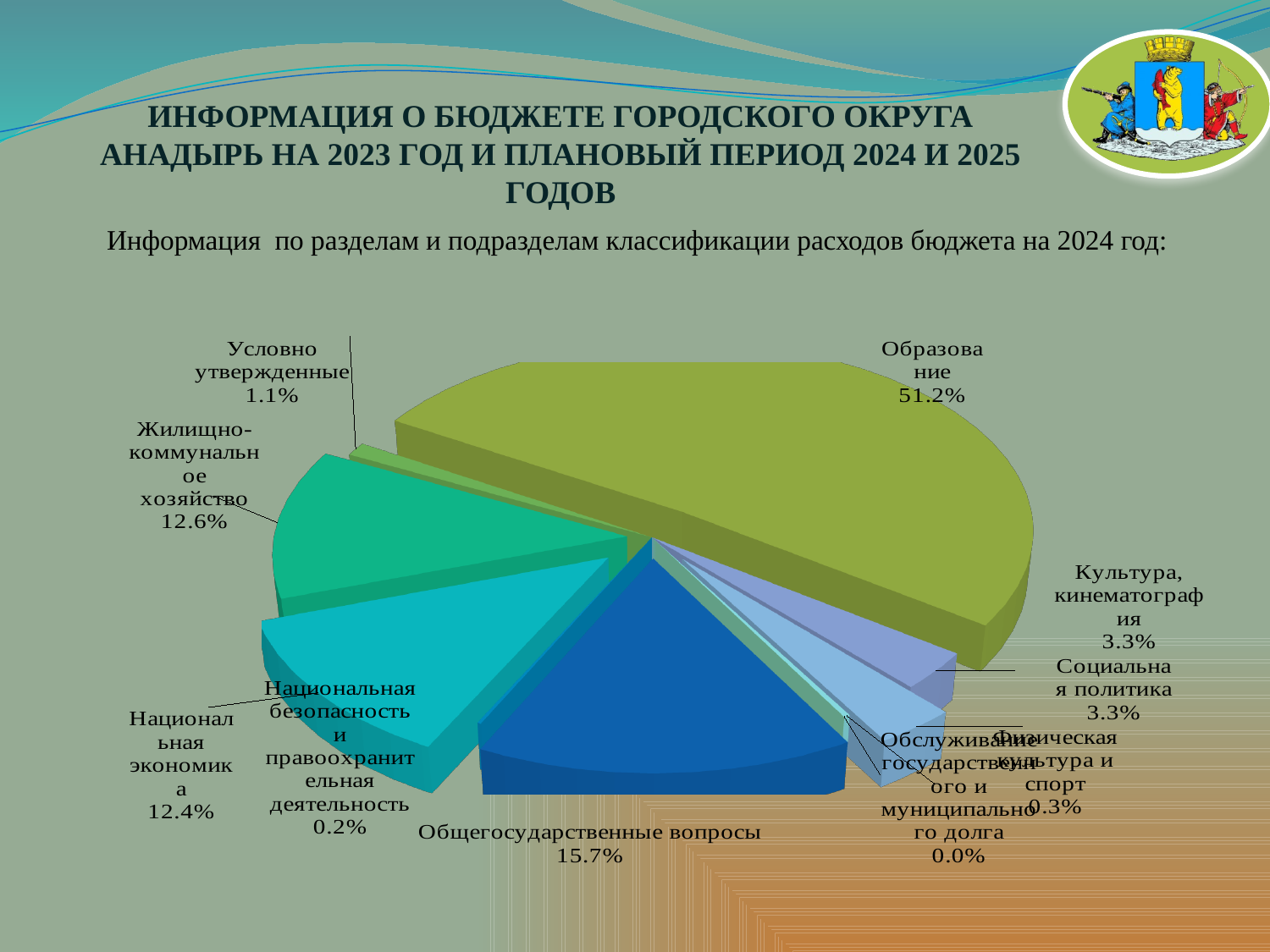
What is the value shown for Жилищно-коммунальное хозяйство? 12.6% Which category has the smallest share of the pie? Обслуживание государственного и муниципального долга What is the value shown for Общегосударственные вопросы? 15.7% How many categories (slices) does the pie chart show? 10 What is the value shown for Национальная экономика? 12.4% What is the difference between the shares of Образование and Общегосударственные вопросы? 35.5% Which is larger: the share for Жилищно-коммунальное хозяйство or for Национальная экономика? Жилищно-коммунальное хозяйство What kind of chart is shown on the slide? pie chart What share of the 2024 budget expenditures goes to Образование? 51.2% What is the value shown for Условно утвержденные? 1.1% What is the value shown for Физическая культура и спорт? 0.3% Which category has the largest share of the pie? Образование